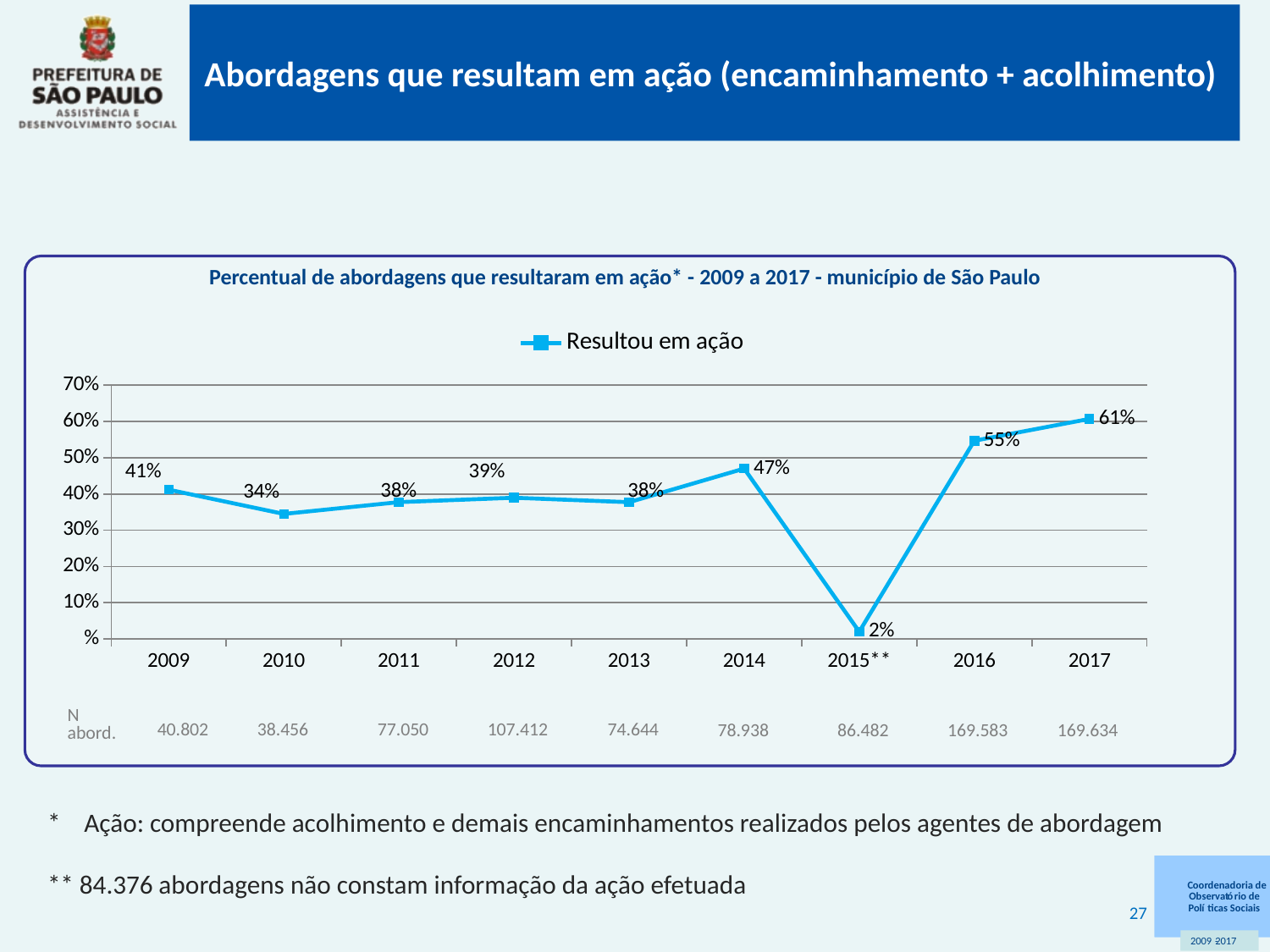
Which year has the lowest value in the chart? 2015** What is the value for 2014 in the chart? 47% What is the difference between the values for 2017 and 2016? 6% What is the name of the series shown in the legend? Resultou em ação What is the value for 2009 in the chart? 41% How many series does the legend list? 1 Which is larger, the value for 2010 or the value for 2012? 2012 Is the value for 2016 greater or less than 50%? greater Which year has the highest value in the chart? 2017 What type of chart is shown on the slide? line chart How many years are plotted on the x axis of the chart? 9 What is the value for 2015** in the chart? 2%